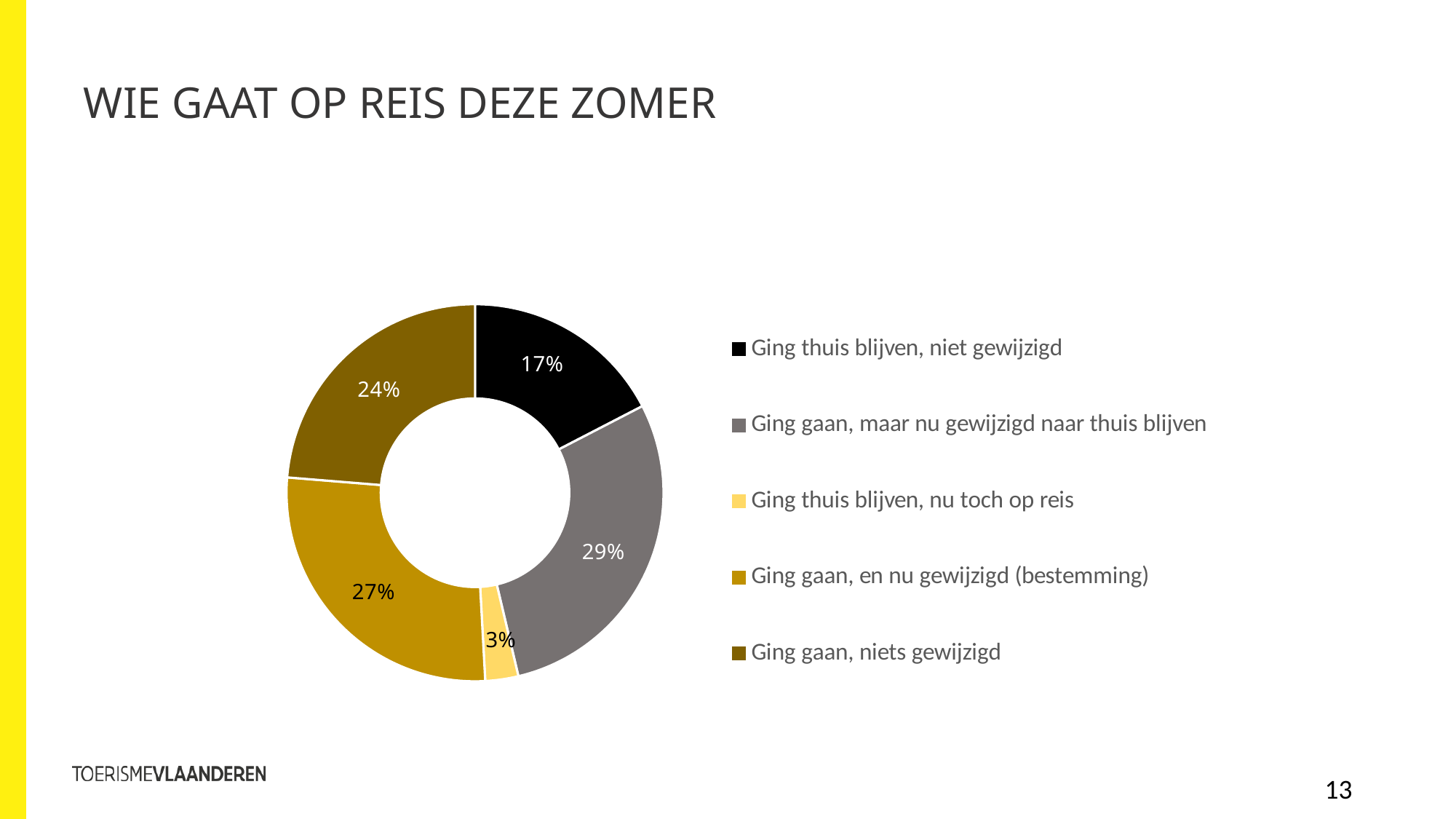
Which is larger: the share for 'Ging gaan, niets gewijzigd' or for 'Ging gaan, en nu gewijzigd (bestemming)'? Ging gaan, en nu gewijzigd (bestemming) What is the difference in percentage points between 'Ging gaan, maar nu gewijzigd naar thuis blijven' and 'Ging thuis blijven, niet gewijzigd'? 12 Which category has the smallest share of the chart? Ging thuis blijven, nu toch op reis What type of chart is shown on the slide? Doughnut (pie) chart What percentage is shown for 'Ging gaan, maar nu gewijzigd naar thuis blijven'? 29% What percentage is shown for 'Ging gaan, niets gewijzigd'? 24% Which category has the largest share of the chart? Ging gaan, maar nu gewijzigd naar thuis blijven What percentage is shown for 'Ging gaan, en nu gewijzigd (bestemming)'? 27% What percentage of respondents are in the 'Ging thuis blijven, niet gewijzigd' category? 17% What is the title of the slide containing the chart? WIE GAAT OP REIS DEZE ZOMER What share does 'Ging thuis blijven, nu toch op reis' have? 3% How many categories does the chart show? 5